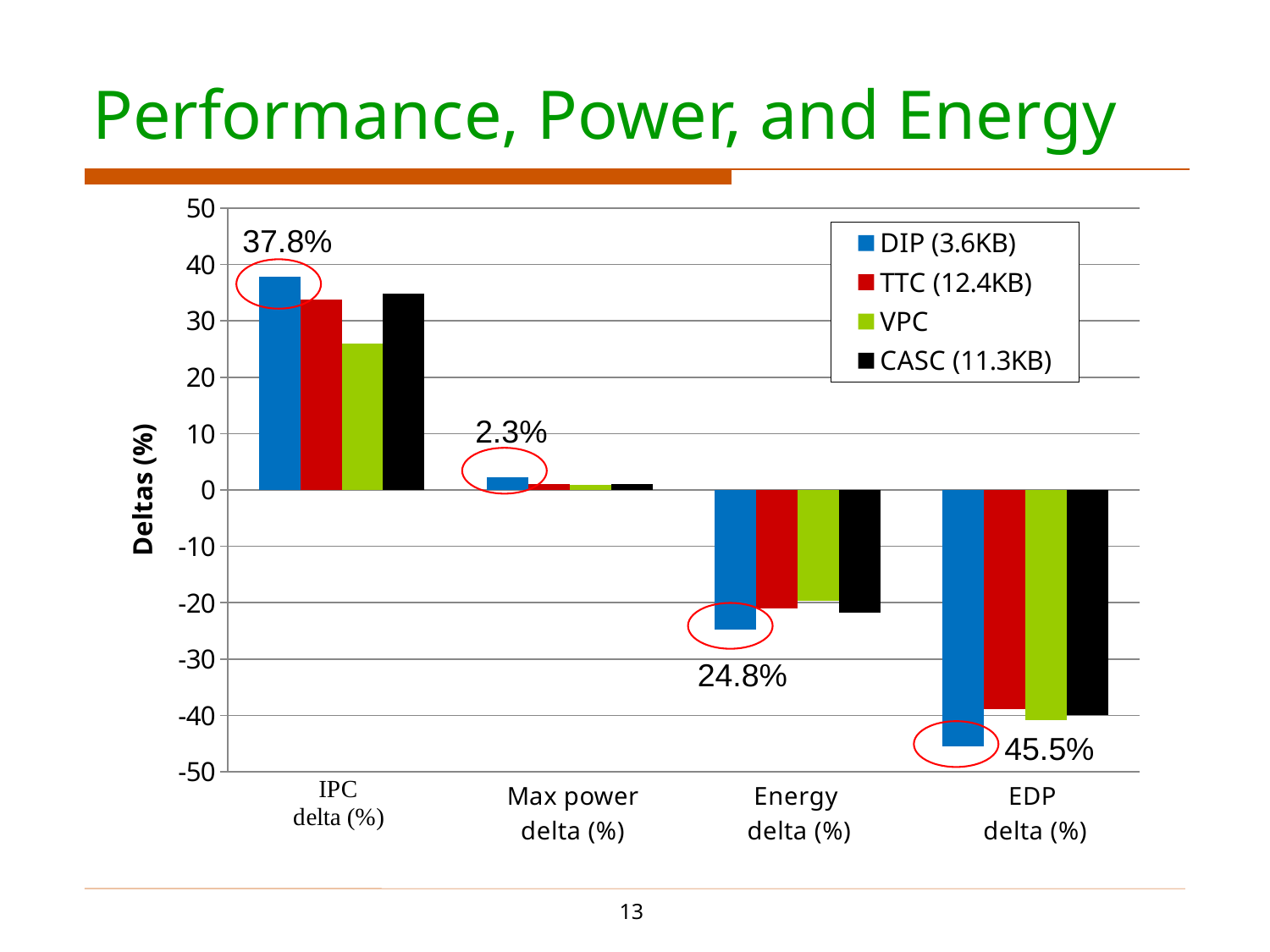
What kind of chart is shown on the slide? Bar chart What is the Max power delta (%) value labelled for DIP (3.6KB)? 2.3% How many categories are shown on the x axis? 4 What value is labelled on the DIP (3.6KB) bar for Energy delta (%)? 24.8% What is the title of the y axis? Deltas (%) Is the IPC delta (%) value for CASC (11.3KB) greater or less than 30? greater What value is labelled on the DIP (3.6KB) bar for EDP delta (%)? 45.5% Which series has the lowest IPC delta (%)? VPC What is the IPC delta (%) value labelled for DIP (3.6KB)? 37.8% Which series has the highest IPC delta (%)? DIP (3.6KB) Is the EDP delta (%) value for TTC (12.4KB) greater or less than -30? less How many series does the legend list? 4